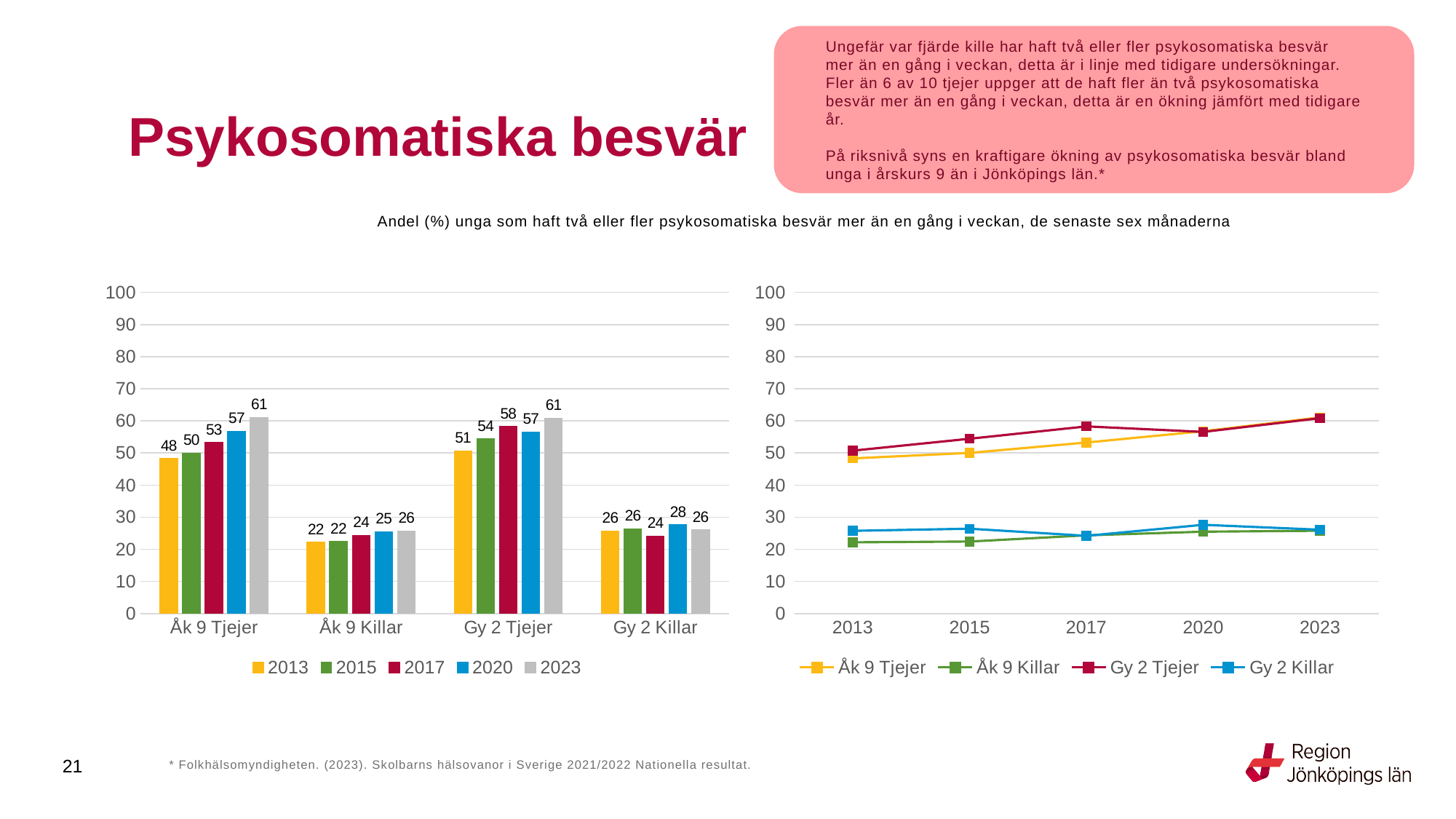
In the bar chart on the left, what is the value for Gy 2 Killar in 2020? 28 What kind of chart is the chart on the right? line chart In the line chart on the right, is the value for Gy 2 Tjejer in 2013 greater or less than 40? greater In the bar chart on the left, how many series does the legend list? 5 In the bar chart on the left, how many categories are shown on the x axis? 4 In the bar chart on the left, what is the value for Åk 9 Killar in 2013? 22 In the bar chart on the left, what is the value for Åk 9 Tjejer in 2023? 61 In the bar chart on the left, which year has the highest value for Gy 2 Tjejer? 2023 In the line chart on the right, do the values for Åk 9 Tjejer rise or fall from 2013 to 2023? rise In the bar chart on the left, which year has the lowest value for Åk 9 Tjejer? 2013 In the bar chart on the left, what is the difference between the 2023 and 2013 values for Åk 9 Tjejer? 13 In the bar chart on the left, which is larger: the 2017 value for Gy 2 Tjejer or the 2017 value for Åk 9 Tjejer? Gy 2 Tjejer